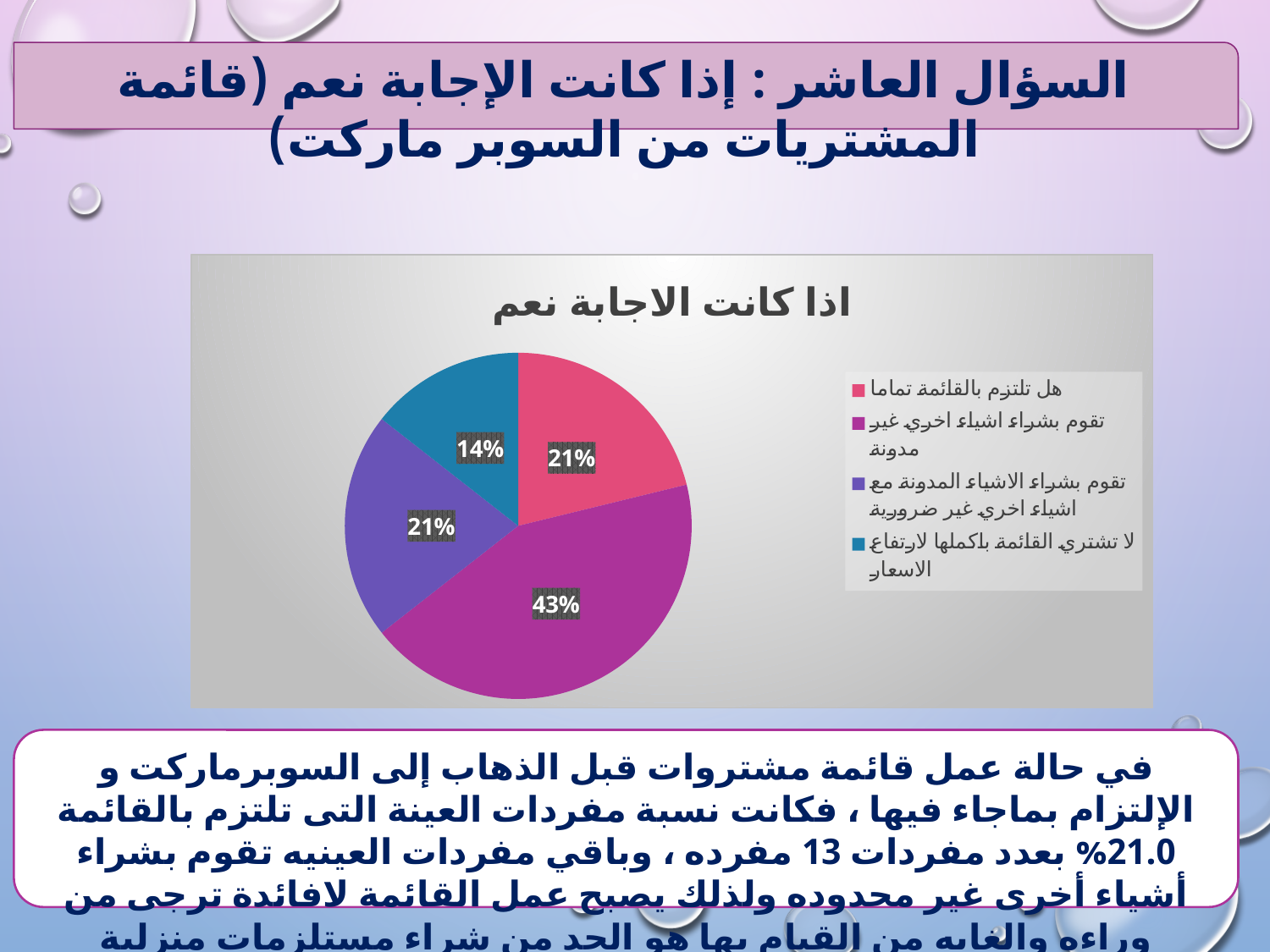
What percentage is shown for the slice 'تقوم بشراء الاشياء المدونة مع اشياء اخري غير ضرورية'? 21% What is the title of the chart? اذا كانت الاجابة نعم What kind of chart is shown on the slide? pie chart What percentage is shown for the slice 'هل تلتزم بالقائمة تماما'? 21% Which is larger: the share for 'هل تلتزم بالقائمة تماما' or the share for 'لا تشتري القائمة باكملها لارتفاع الاسعار'? هل تلتزم بالقائمة تماما Which category has the smallest share of the pie? لا تشتري القائمة باكملها لارتفاع الاسعار How many slices does the pie chart have? 4 What percentage is shown for the slice 'لا تشتري القائمة باكملها لارتفاع الاسعار'? 14% What percentage is shown for the slice 'تقوم بشراء اشياء اخري غير مدونة'? 43% What is the difference in percentage points between the 'تقوم بشراء اشياء اخري غير مدونة' slice and the 'لا تشتري القائمة باكملها لارتفاع الاسعار' slice? 29 How many entries does the legend list? 4 Which category has the largest share of the pie? تقوم بشراء اشياء اخري غير مدونة